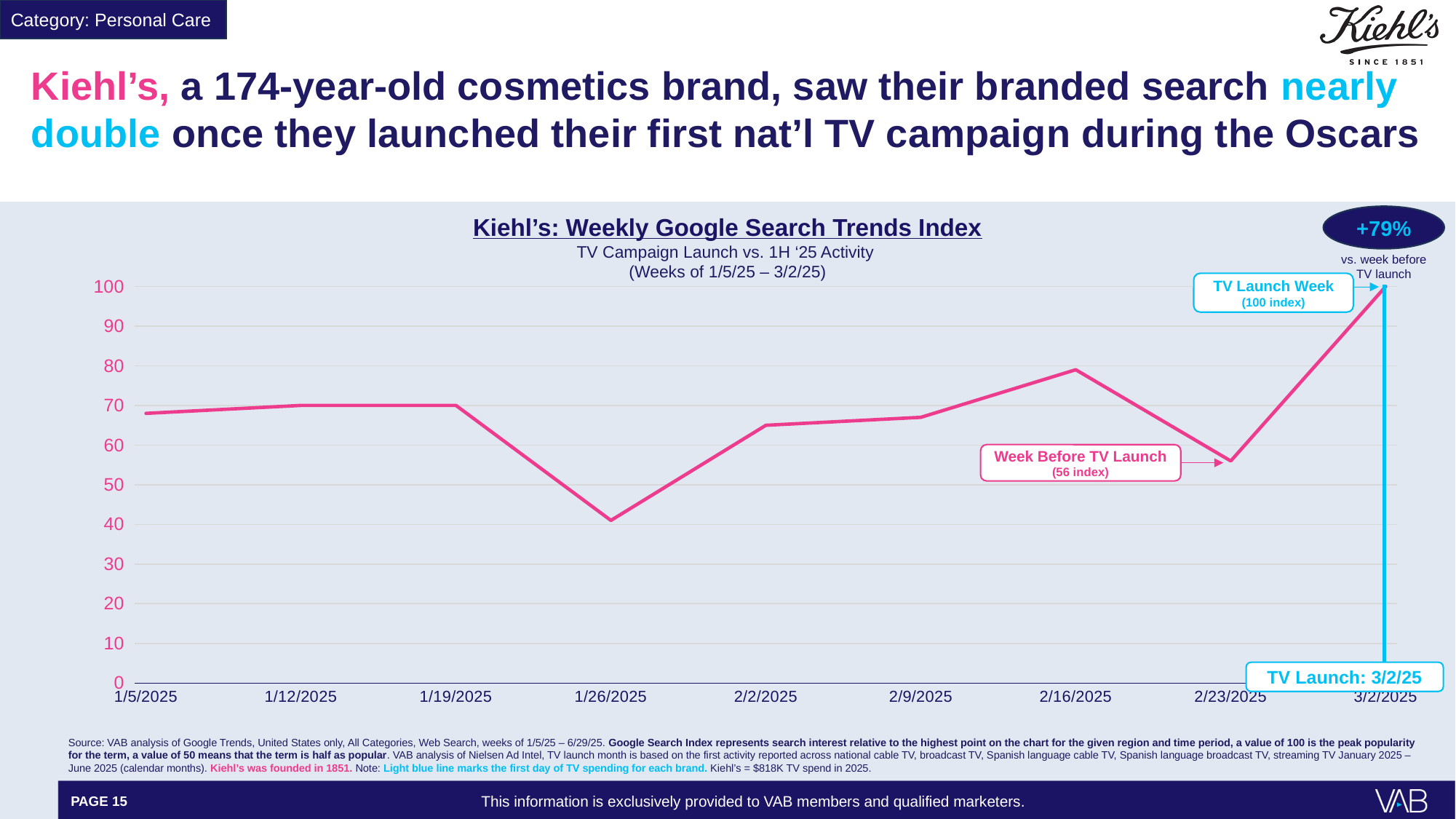
What kind of chart is shown on the slide? Line chart What is the title of the chart? Kiehl's: Weekly Google Search Trends Index Which week has a higher search index value, 2/16/2025 or 2/23/2025? 2/16/2025 What is the search index value for the TV launch week of 3/2/2025? 100 How many weekly data points are plotted on the chart? 9 What percentage change vs. the week before TV launch is called out on the chart? +79% What is the search index value for the week before TV launch (2/23/2025)? 56 What is the difference between the TV launch week index and the week before TV launch index? 44 Which week has the lowest search index value? 1/26/2025 Does the search index rise or fall from 2/23/2025 to 3/2/2025? Rise Which week has the highest search index value? 3/2/2025 Is the search index value for 1/26/2025 greater or less than 50? less